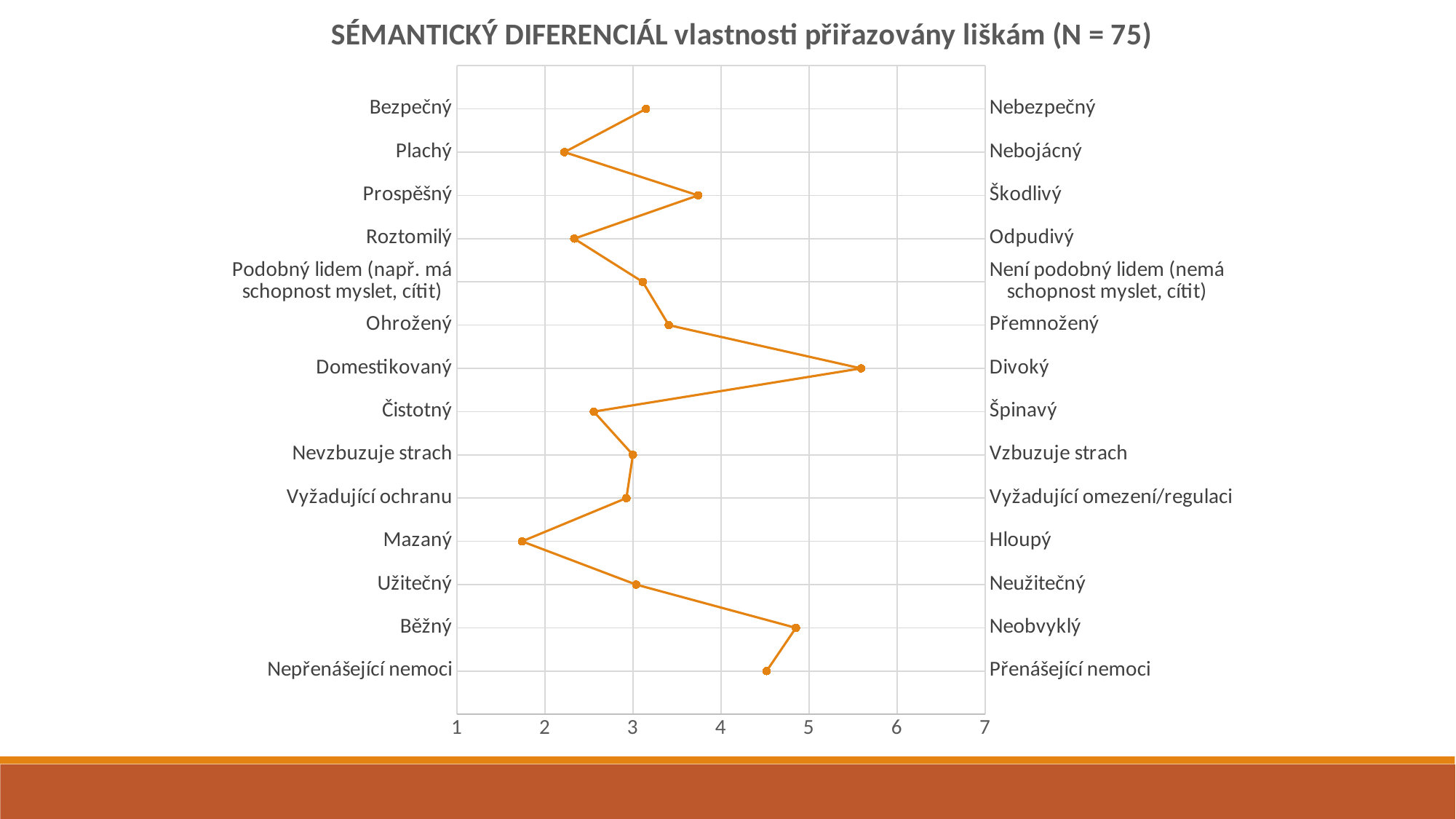
Is the value for Mazaný – Hloupý greater or less than 2? less What is the sample size (N) stated in the chart title? 75 Is the value for Nepřenášející nemoci – Přenášející nemoci greater or less than 4? greater Which has the larger value: Běžný – Neobvyklý or Užitečný – Neužitečný? Běžný – Neobvyklý Is the value for Plachý – Nebojácný greater or less than 3? less What is the range of the horizontal axis scale? 1 to 7 Which adjective pair has the lowest plotted value (furthest to the left)? Mazaný – Hloupý What kind of chart is shown on the slide? line chart How many adjective pairs (rows) are plotted on the chart? 14 Which has the larger value: Prospěšný – Škodlivý or Roztomilý – Odpudivý? Prospěšný – Škodlivý Which adjective pair has the highest plotted value (furthest to the right)? Domestikovaný – Divoký